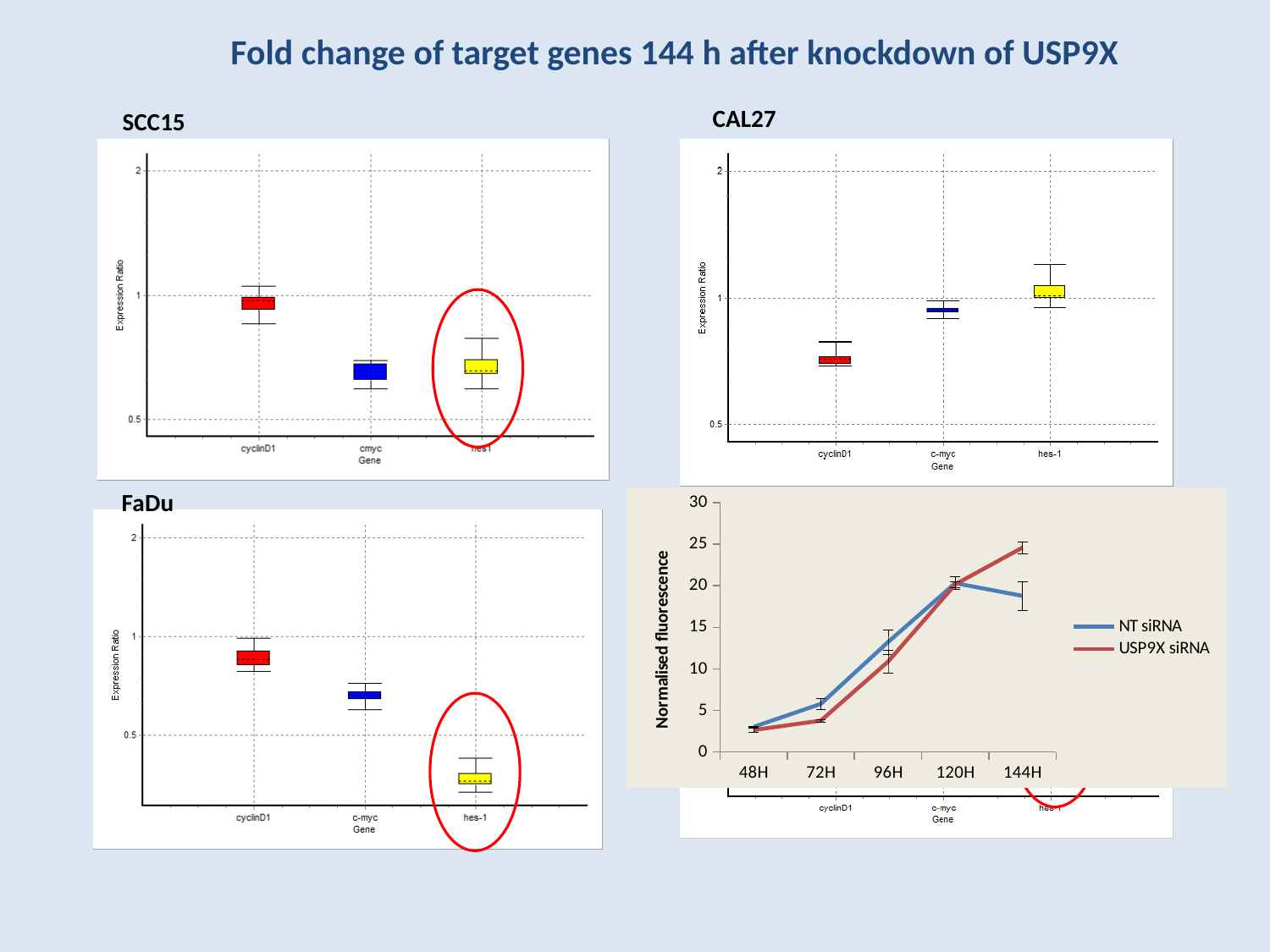
In the normalised fluorescence line chart, which series has the higher value at 144H, NT siRNA or USP9X siRNA? USP9X siRNA In the normalised fluorescence line chart, is the NT siRNA value at 48H greater or less than 5? less How many time points are plotted along the x axis of the normalised fluorescence line chart? 5 How many genes are shown on the x axis of the FaDu chart? 3 How many series does the legend of the normalised fluorescence line chart list? 2 In the SCC15 chart, which gene has the highest expression ratio? cyclinD1 In the CAL27 chart, which gene has the highest expression ratio? hes-1 In the normalised fluorescence line chart, is the USP9X siRNA value at 144H greater or less than 20? greater What kind of chart is the bottom-right chart showing normalised fluorescence? line chart In the normalised fluorescence line chart, does the USP9X siRNA series rise or fall from 48H to 144H? rise In the FaDu chart, is the expression ratio for hes-1 greater or less than 0.5? less In the CAL27 chart, which gene has the lowest expression ratio? cyclinD1